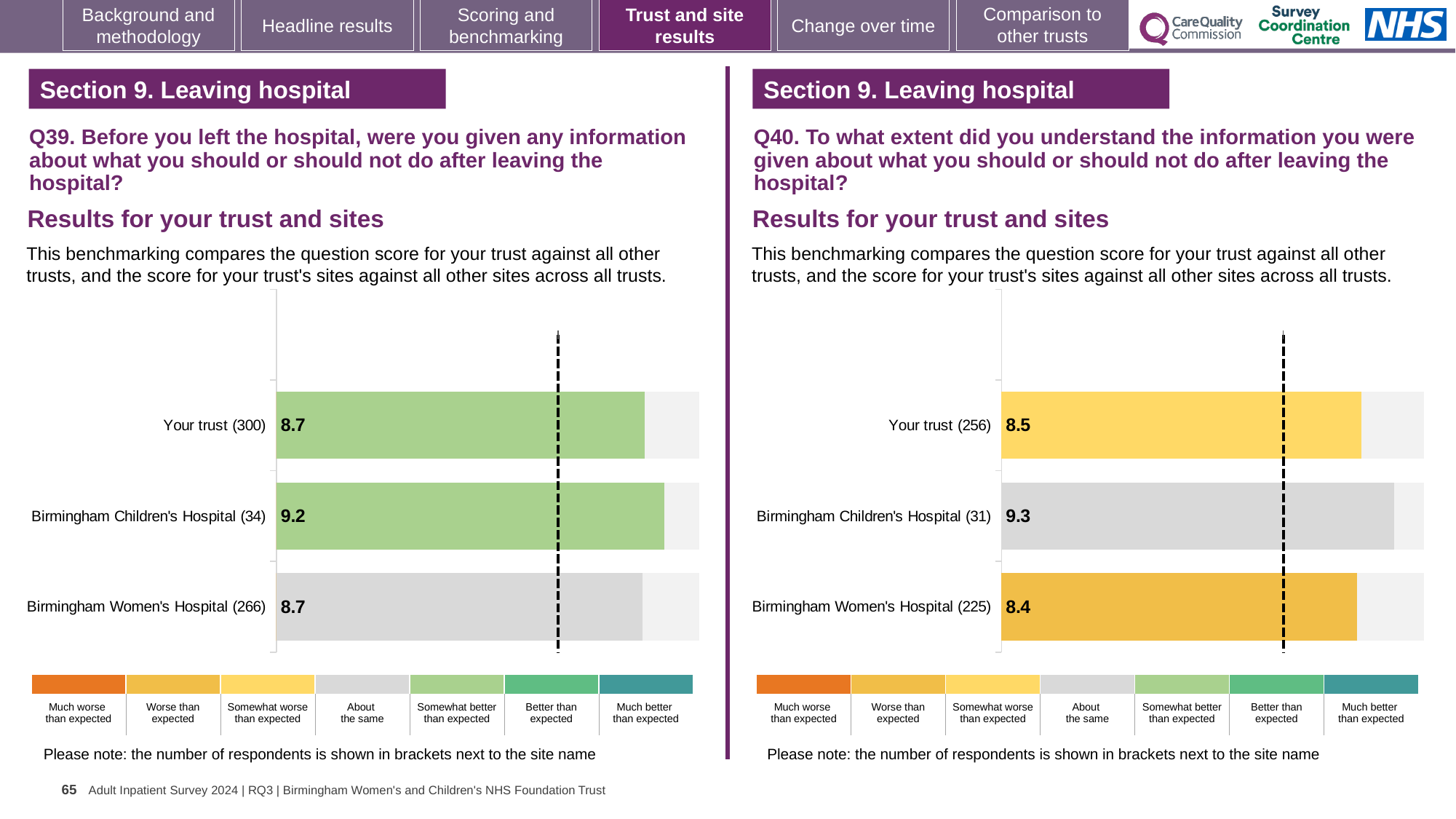
In the Q39 chart on the left, what is the score for Birmingham Children's Hospital? 9.2 In the Q40 chart on the right, how many respondents are shown in brackets for Birmingham Women's Hospital? 225 In the Q39 chart on the left, what is the score for Your trust? 8.7 In the Q40 chart on the right, which site or trust has the highest score? Birmingham Children's Hospital In the Q40 chart on the right, what is the score for Birmingham Women's Hospital? 8.4 How many bars are shown in the Q39 chart on the left? 3 What type of chart is used for the Q40 results on the right? Bar chart In the Q40 chart on the right, which site or trust has the lowest score? Birmingham Women's Hospital In the Q39 chart on the left, what is the difference between the score for Birmingham Children's Hospital and the score for Birmingham Women's Hospital? 0.5 In the Q40 chart on the right, what is the score for Your trust? 8.5 In the Q40 chart on the right, what is the difference between the score for Birmingham Children's Hospital and the score for Your trust? 0.8 In the Q39 chart on the left, which has the higher score: Your trust or Birmingham Children's Hospital? Birmingham Children's Hospital